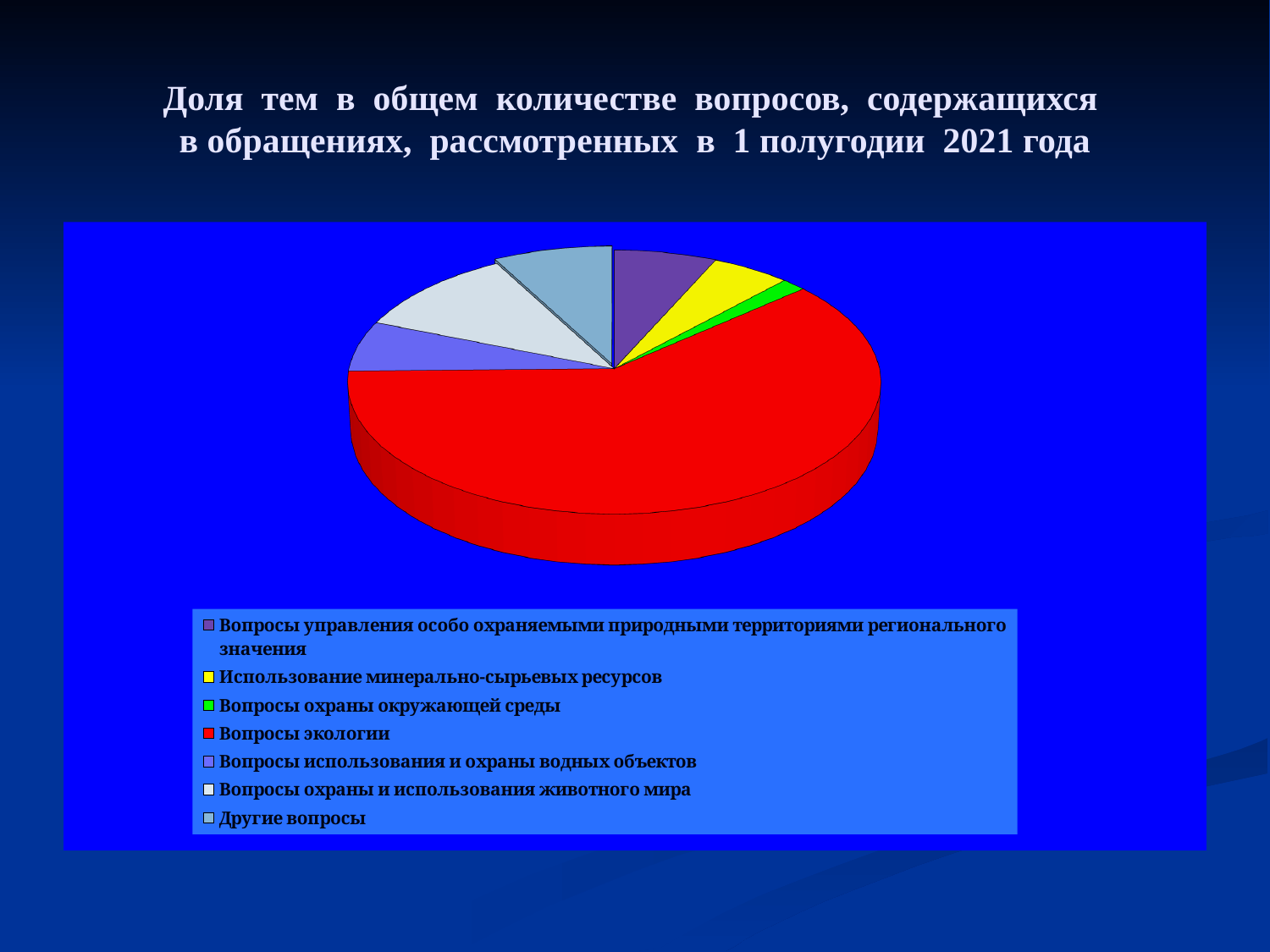
Which category has the largest share of the pie? Вопросы экологии Which slice is larger: Вопросы охраны и использования животного мира or Вопросы охраны окружающей среды? Вопросы охраны и использования животного мира Which slice is larger: Вопросы экологии or Использование минерально-сырьевых ресурсов? Вопросы экологии Which category has the smallest share of the pie? Вопросы охраны окружающей среды How many categories (slices) does the pie chart have? 7 Which slice is larger: Вопросы использования и охраны водных объектов or Вопросы охраны окружающей среды? Вопросы использования и охраны водных объектов What kind of chart is shown on the slide? pie chart What is the title of the slide? Доля тем в общем количестве вопросов, содержащихся в обращениях, рассмотренных в 1 полугодии 2021 года What colour is the slice for Вопросы экологии? red How many entries does the legend list? 7